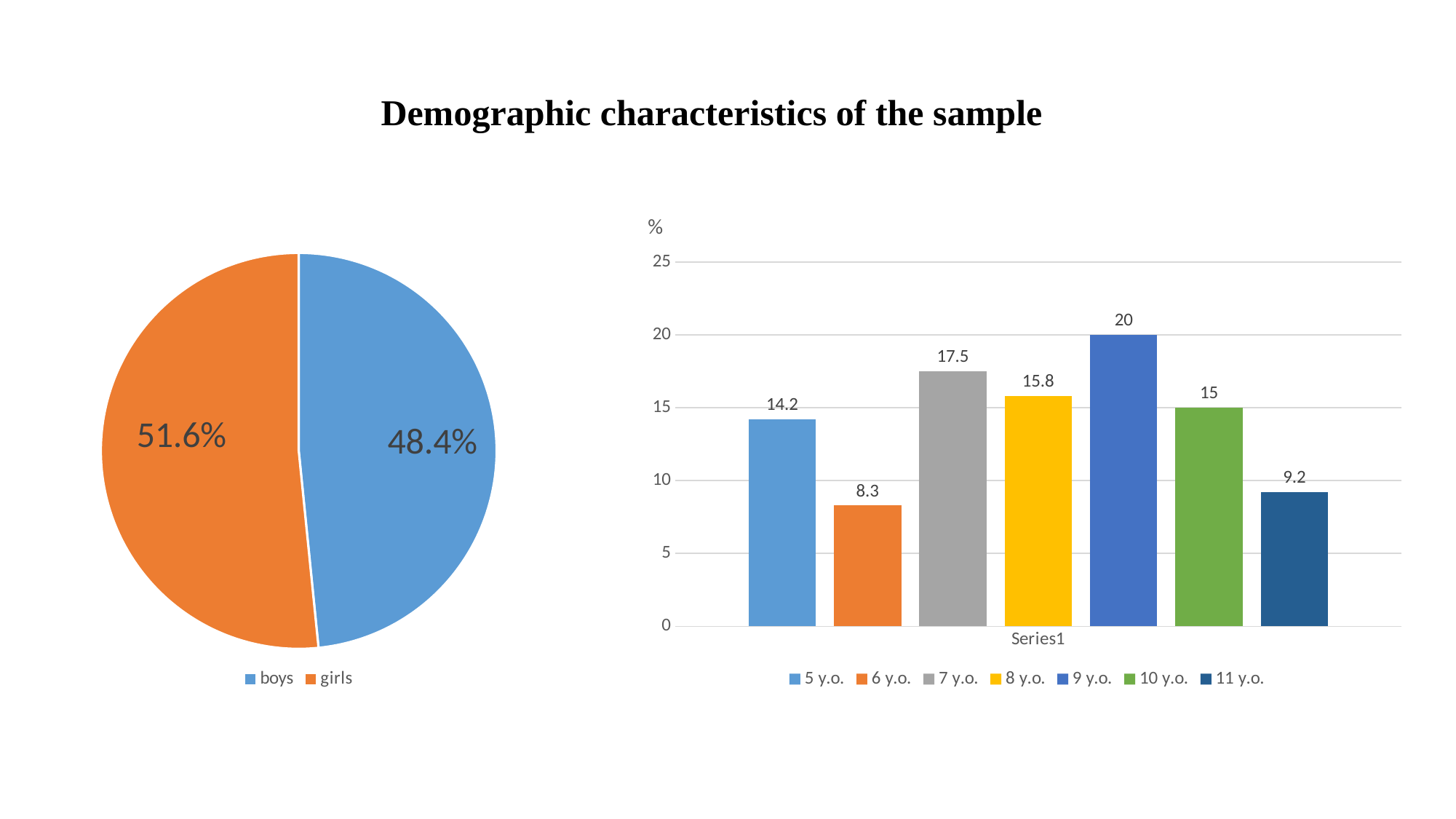
In the bar chart on the right, which age group has the lowest value? 6 y.o. In the pie chart on the left, what share of the sample is girls? 51.6% In the bar chart on the right, what is the difference between the values for 7 y.o. and 5 y.o.? 3.3 What kind of chart is the chart on the left? pie chart How many age groups does the legend of the bar chart on the right list? 7 In the bar chart on the right, what is the value for 6 y.o.? 8.3 In the bar chart on the right, is the value for 11 y.o. greater or less than 10? less What kind of chart is the chart on the right? bar chart In the pie chart on the left, which group has the larger share, boys or girls? girls In the pie chart on the left, what share of the sample is boys? 48.4% In the bar chart on the right, which age group has the highest value? 9 y.o. In the bar chart on the right, what is the value for 9 y.o.? 20